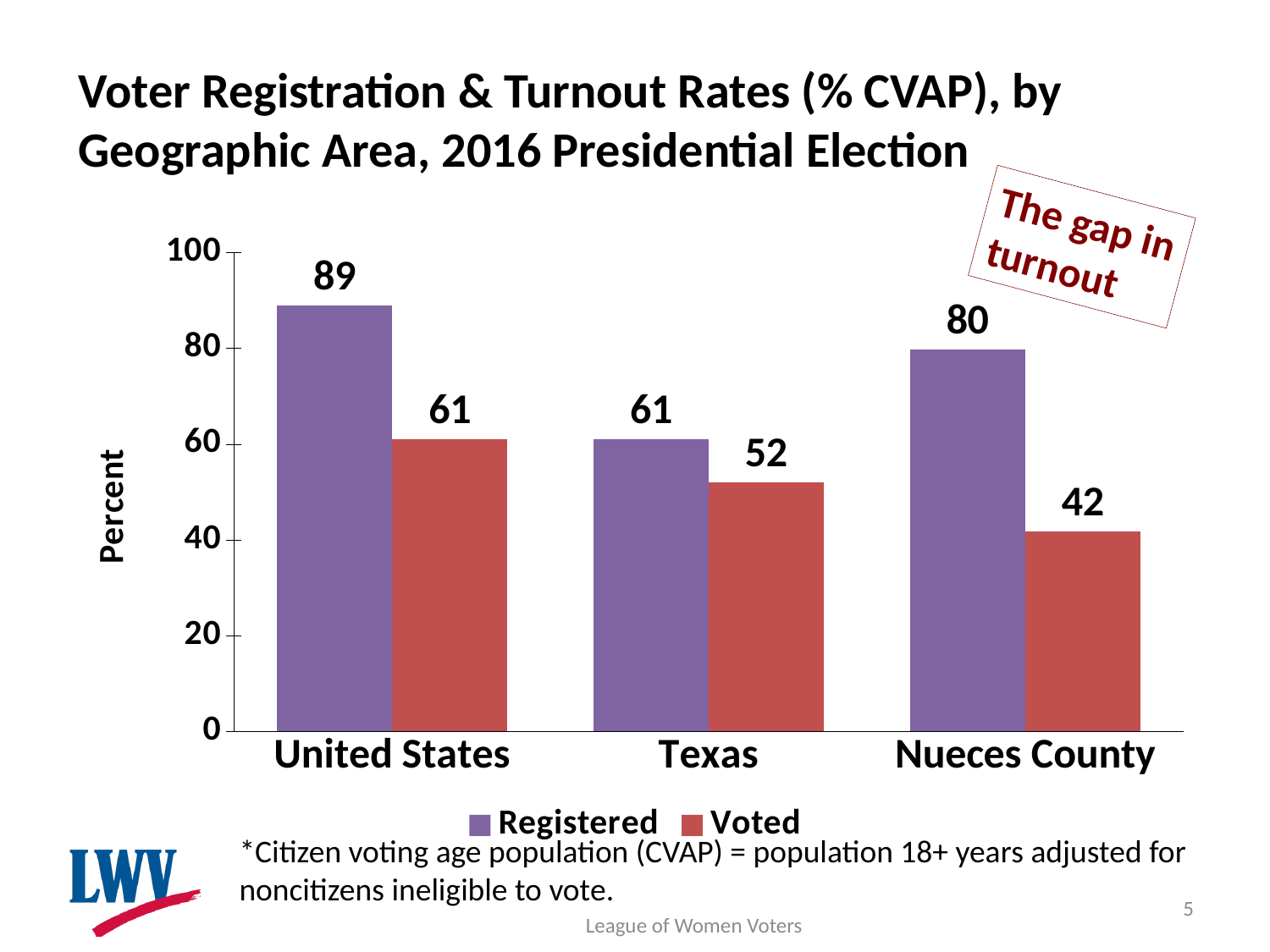
Which is larger: the Voted value for the United States or the Voted value for Texas? United States What is the difference between the Registered values for the United States and Texas? 28 What is the label on the vertical axis? Percent How many geographic areas are shown on the x axis? 3 Which geographic area has the highest Registered value? United States What kind of chart is shown on the slide? Bar chart Which geographic area has the lowest Voted value? Nueces County What is the Registered value for the United States? 89 What is the Voted value for Nueces County? 42 How many series does the legend list? 2 What is the difference between the Registered and Voted values for Nueces County? 38 What is the Voted value for Texas? 52